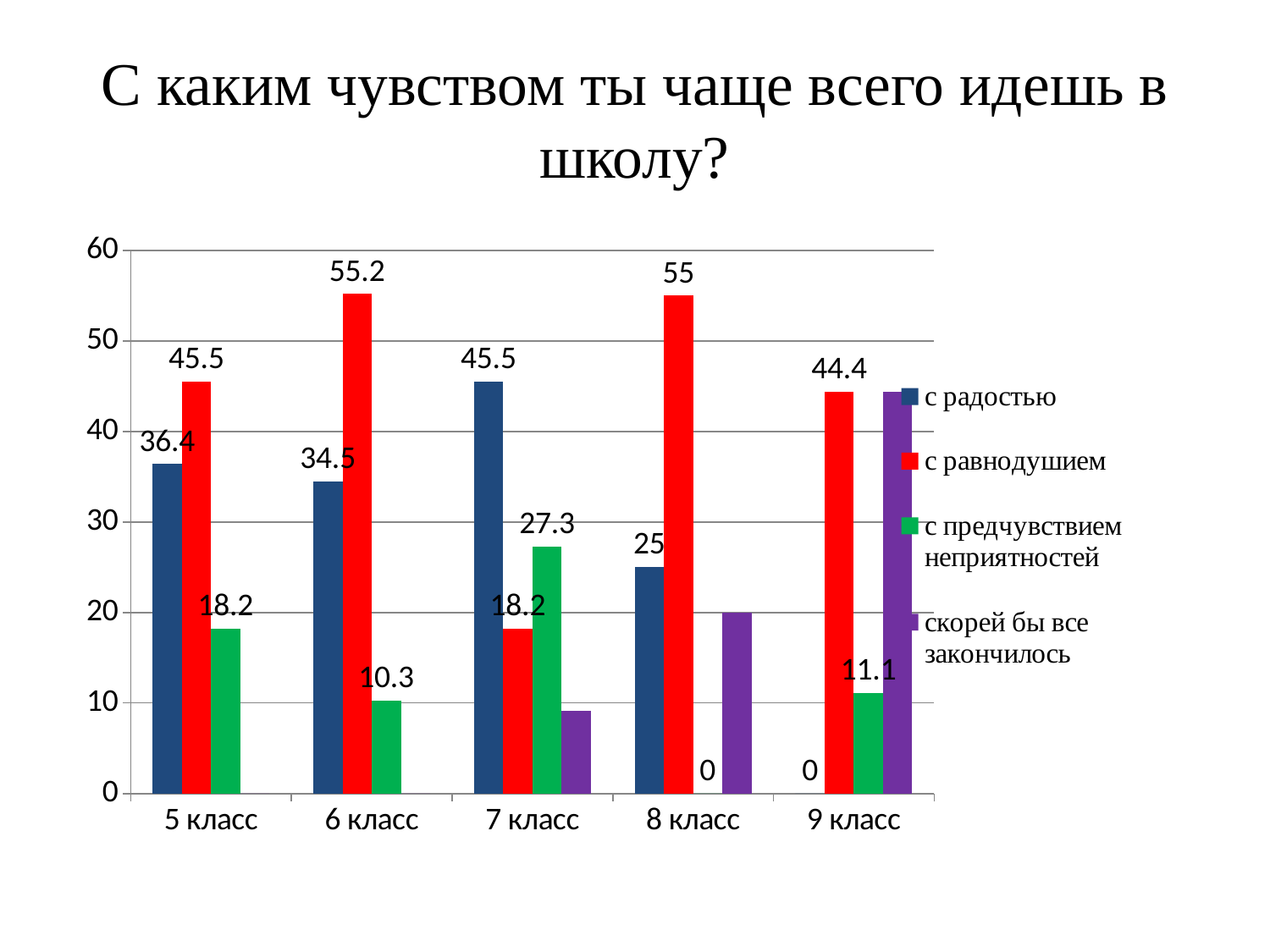
How many classes are shown on the x axis? 5 What is the value for «с предчувствием неприятностей» in 9 класс? 11.1 How many series does the legend list? 4 In 6 класс, what is the difference between «с равнодушием» and «с предчувствием неприятностей»? 44.9 What kind of chart is shown on the slide? bar chart Is the value for «скорей бы все закончилось» in 8 класс greater or less than 30? less In 5 класс, what is the difference between «с равнодушием» and «с радостью»? 9.1 Which class has the lowest value for «с предчувствием неприятностей»? 8 класс In 7 класс, which is larger: «с радостью» or «с равнодушием»? с радостью Which class has the highest value for «с радостью»? 7 класс What is the value for «с равнодушием» in 6 класс? 55.2 What is the value for «с радостью» in 7 класс? 45.5